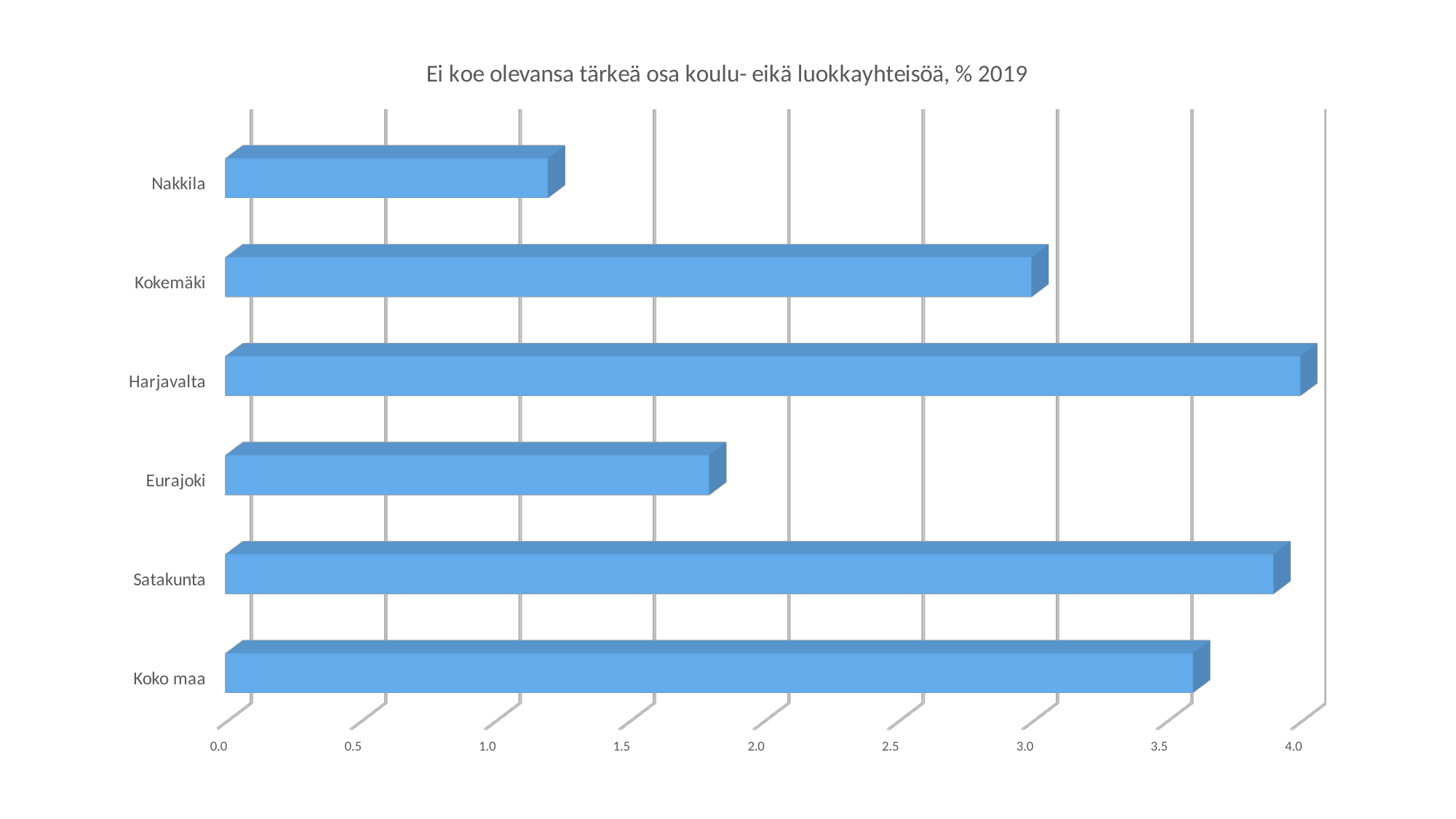
Is the value for Satakunta greater or less than 3.5? greater Which category has the highest value? Harjavalta Is the value for Kokemäki greater or less than 2.5? greater Which category has the lowest value? Nakkila Which is larger, the value for Nakkila or the value for Eurajoki? Eurajoki Is the value for Koko maa greater or less than 3.0? greater What is the title of the chart? Ei koe olevansa tärkeä osa koulu- eikä luokkayhteisöä, % 2019 How many categories are plotted in the chart? 6 Which is larger, the value for Kokemäki or the value for Eurajoki? Kokemäki What kind of chart is shown on the slide? bar chart